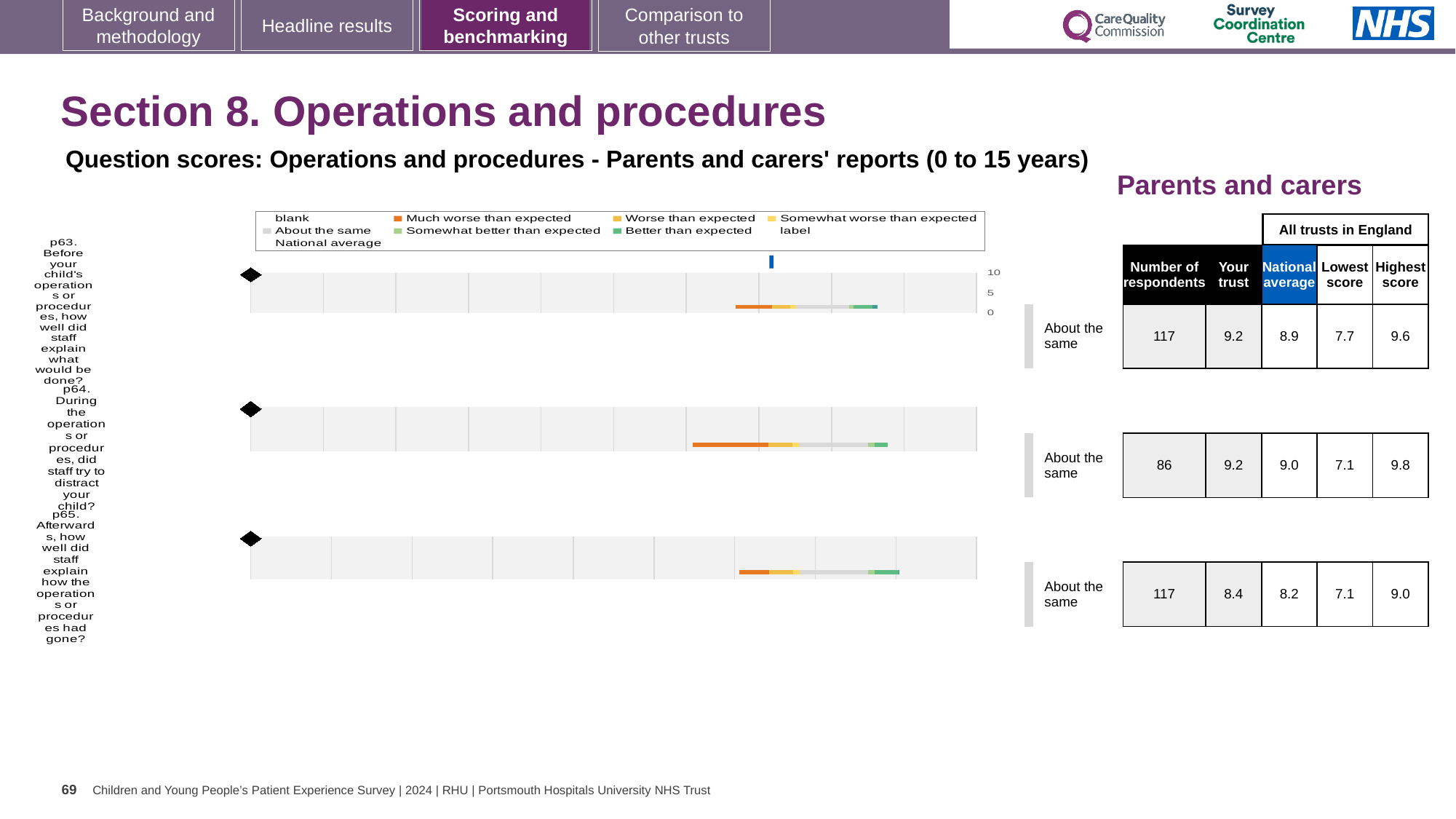
Which question has the higher 'Highest score' value, p63 or p64? p64 What kind of chart is used to show the question scores on this slide? Bar chart What benchmark category is shown next to the chart for question p64? About the same For question p63 (Before your child's operations or procedures, how well did staff explain what would be done?), how many respondents are shown? 117 For question p65, what is the difference between the 'Your trust' score and the national average? 0.2 What is the highest score among all trusts in England for question p64? 9.8 What is the national average score for question p65 (Afterwards, how well did staff explain how the operations or procedures had gone?)? 8.2 What is the lowest score among all trusts in England for question p63? 7.7 What is the 'Your trust' score for question p64 (During the operations or procedures, did staff try to distract your child?)? 9.2 Is the 'Your trust' score for question p63 greater or less than 5? greater How many survey questions are charted on this slide? 3 Which of the three questions has the lowest 'Your trust' score? p65